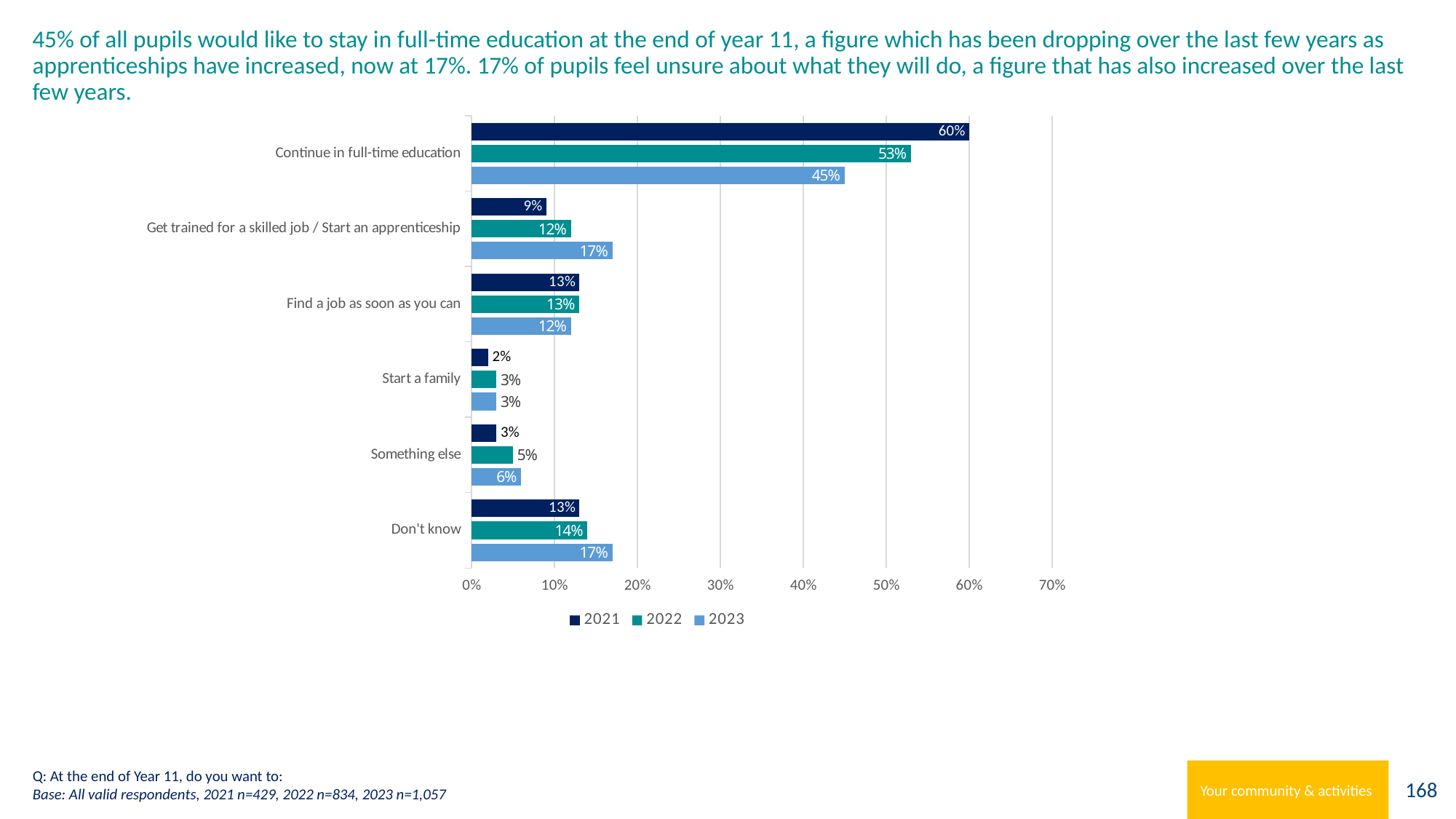
Which years are listed in the chart legend? 2021, 2022, 2023 Did the value for 'Get trained for a skilled job / Start an apprenticeship' rise or fall from 2021 to 2023? Rise What percentage of pupils in 2023 wanted to continue in full-time education? 45% What kind of chart is shown on the slide? Bar chart What was the value for 'Get trained for a skilled job / Start an apprenticeship' in 2021? 9% How many series does the legend list? 3 Which is larger for 'Something else': the 2022 value or the 2023 value? 2023 What was the 2022 value for 'Don't know'? 14% Which category has the highest value for 2021? Continue in full-time education How many categories are shown on the chart? 6 Which category has the lowest value for 2021? Start a family By how many percentage points did 'Continue in full-time education' fall from 2021 to 2023? 15 percentage points